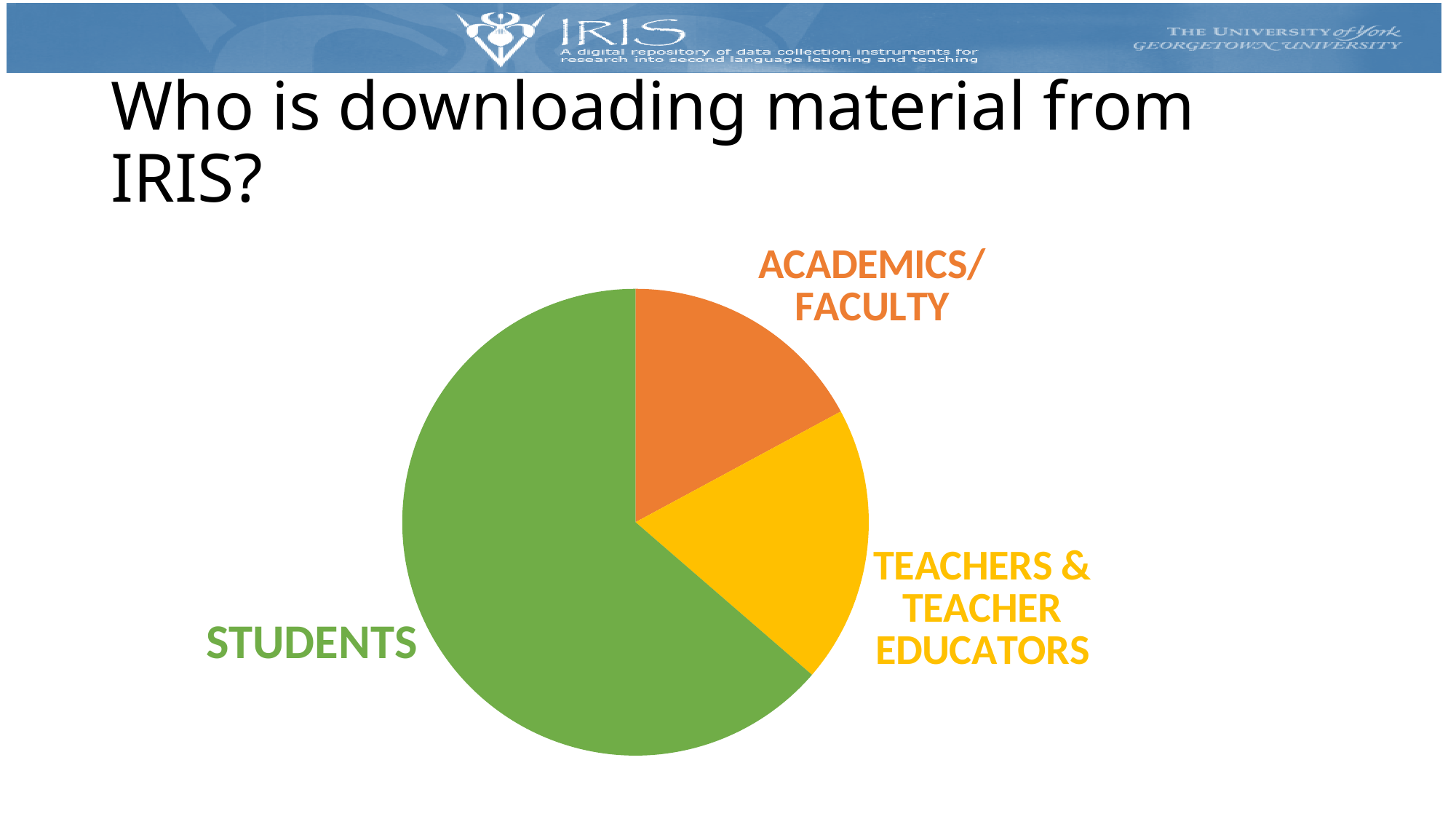
Is the Students slice greater or less than half of the pie? greater Which slice is larger, Students or Teachers & Teacher Educators? Students Which category is shown in orange on the pie chart? Academics/Faculty What colour is the Students slice of the pie chart? green Which category has the largest slice of the pie chart? Students Which slice is larger, Students or Academics/Faculty? Students What is the title of the slide containing the pie chart? Who is downloading material from IRIS? How many slices does the pie chart have? 3 What kind of chart is shown on the slide? pie chart